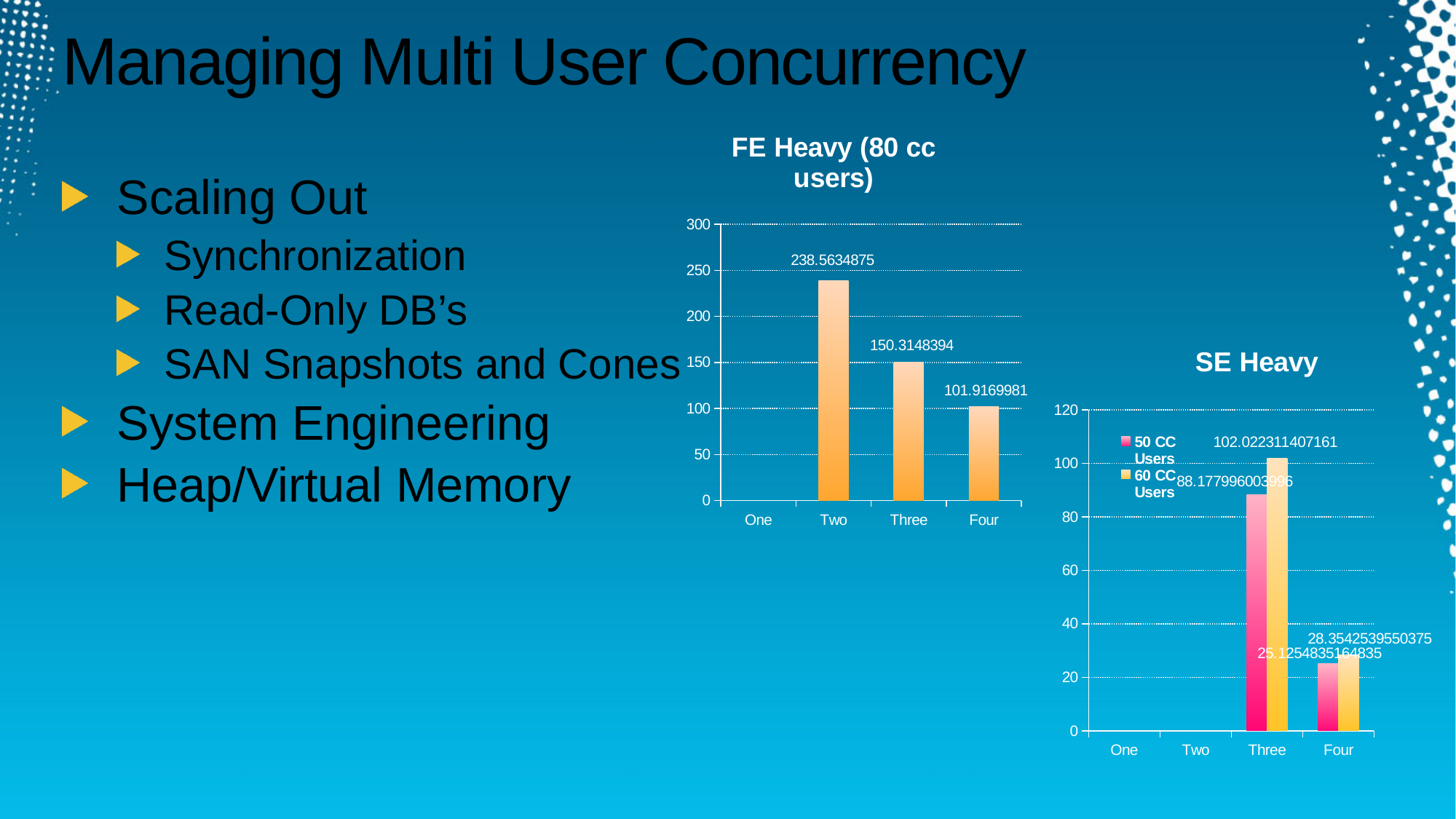
In the SE Heavy chart, what is the value for 60 CC Users at Four? 28.3542539550375 In the SE Heavy chart, at Three, which series has the larger value: 50 CC Users or 60 CC Users? 60 CC Users In the SE Heavy chart, what is the value for 60 CC Users at Three? 102.022311407161 In the SE Heavy chart, is the value for 50 CC Users at Three greater or less than 80? greater In the FE Heavy (80 cc users) chart, what is the value for Two? 238.5634875 What kind of chart is the FE Heavy (80 cc users) chart? bar chart In the FE Heavy (80 cc users) chart, which category has the highest value? Two In the SE Heavy chart, how many series does the legend list? 2 In the FE Heavy (80 cc users) chart, what is the value for Four? 101.9169981 In the FE Heavy (80 cc users) chart, what is the difference between the values for Two and Three? 88.2486481 In the FE Heavy (80 cc users) chart, do the values rise or fall from Two to Four? fall In the FE Heavy (80 cc users) chart, what is the value for Three? 150.3148394